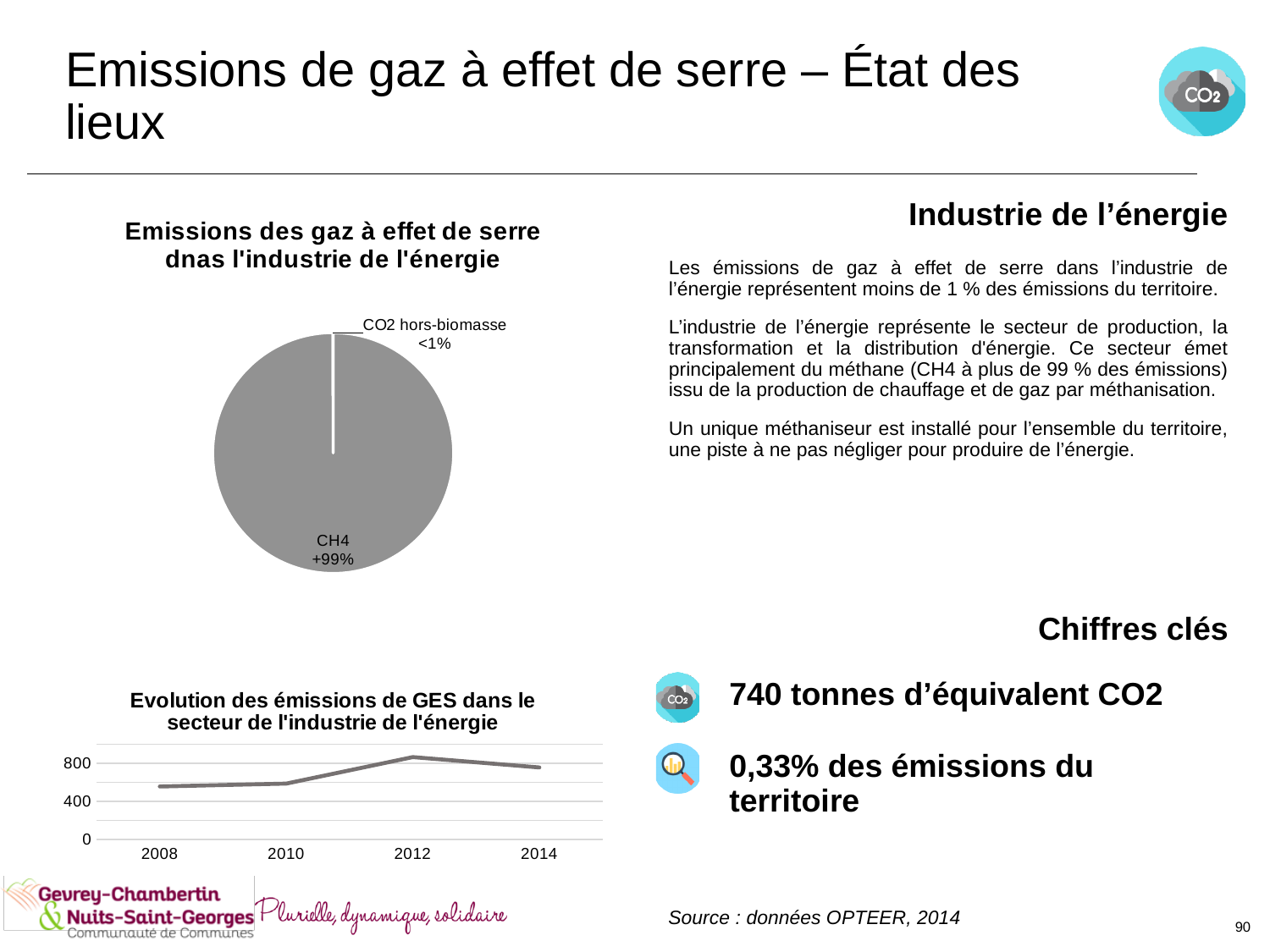
What type of chart is the bottom-left chart titled 'Evolution des émissions de GES dans le secteur de l'industrie de l'énergie'? line chart In the chart 'Evolution des émissions de GES dans le secteur de l'industrie de l'énergie', is the value for 2012 larger or smaller than the value for 2008? larger In the chart 'Evolution des émissions de GES dans le secteur de l'industrie de l'énergie', is the value for 2008 greater or less than 400? greater In the chart 'Evolution des émissions de GES dans le secteur de l'industrie de l'énergie', is the value for 2012 greater or less than 800? greater In the chart 'Evolution des émissions de GES dans le secteur de l'industrie de l'énergie', is the value for 2014 greater or less than 800? less What type of chart is the top-left chart titled 'Emissions des gaz à effet de serre dnas l'industrie de l'énergie'? pie chart How many slices does the pie chart 'Emissions des gaz à effet de serre dnas l'industrie de l'énergie' have? 2 In the pie chart 'Emissions des gaz à effet de serre dnas l'industrie de l'énergie', what share is shown for CO2 hors-biomasse? <1% In the pie chart 'Emissions des gaz à effet de serre dnas l'industrie de l'énergie', what share is shown for CH4? +99% In the pie chart 'Emissions des gaz à effet de serre dnas l'industrie de l'énergie', which slice is the largest? CH4 How many years are shown on the x axis of the chart 'Evolution des émissions de GES dans le secteur de l'industrie de l'énergie'? 4 In the chart 'Evolution des émissions de GES dans le secteur de l'industrie de l'énergie', which year has the highest value? 2012